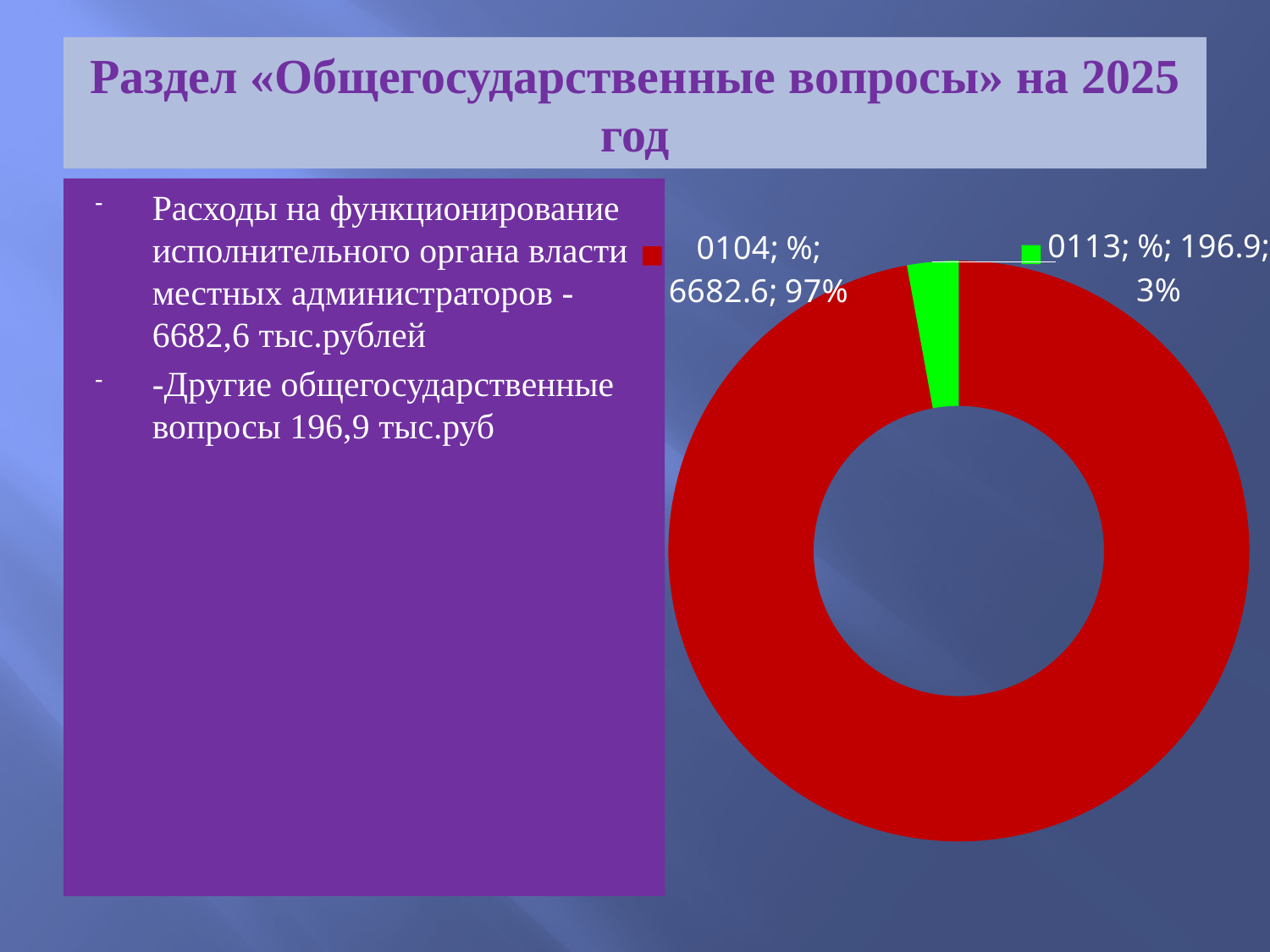
What colour is the slice for category 0113? green What is the total of the two values shown in the chart? 6879.5 What value is shown for category 0113? 196.9 What share of the chart does category 0104 represent? 97% What value is shown for category 0104? 6682.6 Which category has the largest slice? 0104 Which category has the smallest slice? 0113 How many slices does the chart have? 2 Which is larger, the value for 0104 or the value for 0113? 0104 What kind of chart is shown on the slide? doughnut (pie) chart What share of the chart does category 0113 represent? 3% What is the difference between the values for 0104 and 0113? 6485.7